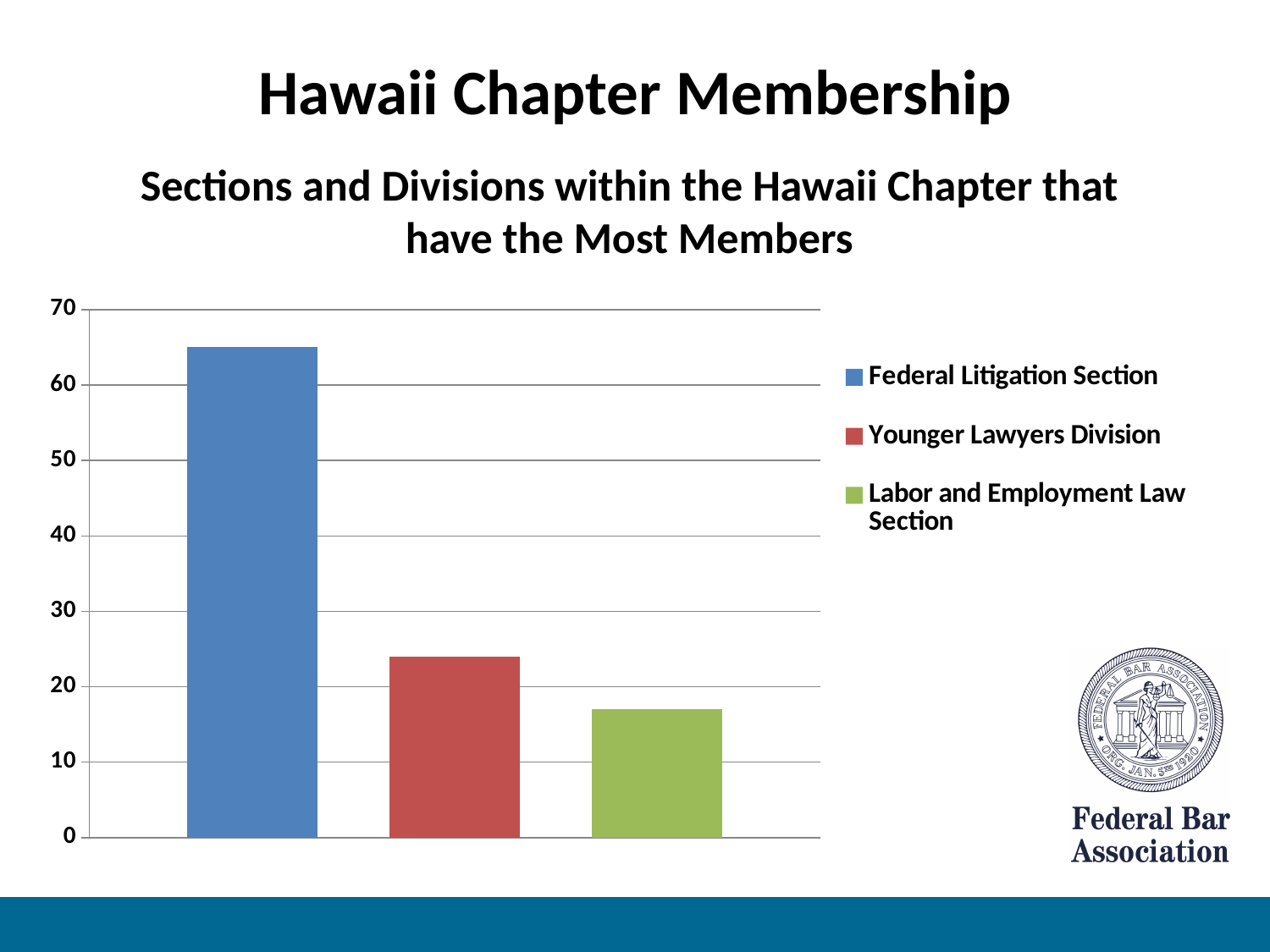
Is the value for the Federal Litigation Section greater or less than 60? greater Which has more members, the Younger Lawyers Division or the Labor and Employment Law Section? Younger Lawyers Division What kind of chart is shown on the slide? bar chart How many bars are plotted in the chart? 3 Is the value for the Younger Lawyers Division greater or less than 30? less What colour is the bar for the Younger Lawyers Division? red What is the title of the chart? Sections and Divisions within the Hawaii Chapter that have the Most Members Which has more members, the Federal Litigation Section or the Younger Lawyers Division? Federal Litigation Section Is the value for the Labor and Employment Law Section greater or less than 20? less How many series does the legend list? 3 Which section or division has the highest membership in the chart? Federal Litigation Section Which section or division has the lowest membership in the chart? Labor and Employment Law Section